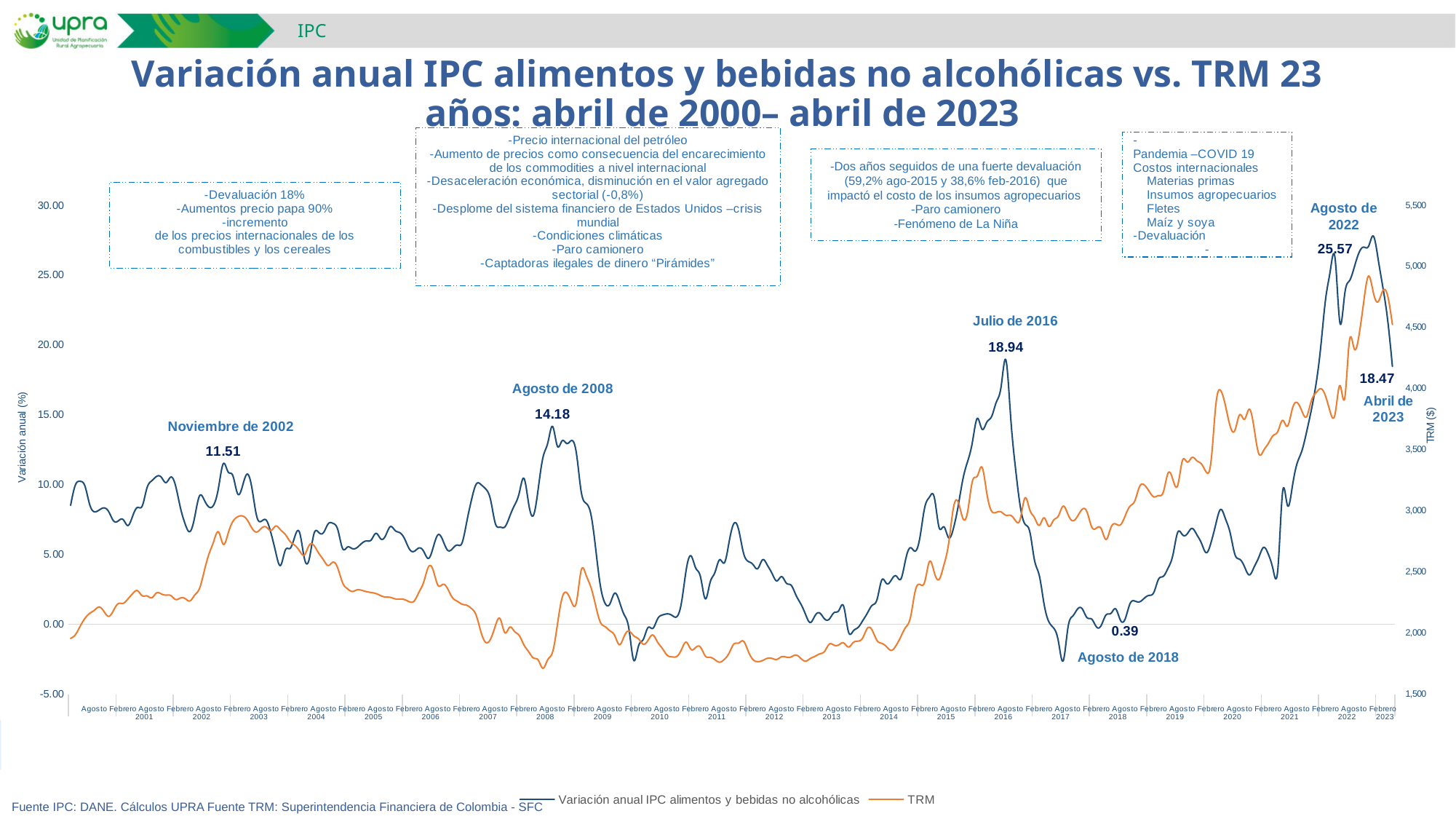
Which labelled point has the highest annual IPC variation? Agosto de 2022 What is the labelled value of the annual IPC variation for Noviembre de 2002? 11.51 Which labelled point has the lowest annual IPC variation? Agosto de 2018 What is the labelled value of the annual IPC variation for Agosto de 2018? 0.39 How many series does the legend list? 2 What is the difference between the labelled IPC values for Agosto de 2022 and Abril de 2023? 7.10 Which is larger, the labelled IPC value for Julio de 2016 or for Agosto de 2008? Julio de 2016 What kind of chart is shown on the slide? line chart What is the labelled value of the annual IPC variation for Agosto de 2022? 25.57 What is the labelled value of the annual IPC variation for Abril de 2023? 18.47 What is the labelled value of the annual IPC variation for Agosto de 2008? 14.18 What is the labelled value of the annual IPC variation for Julio de 2016? 18.94